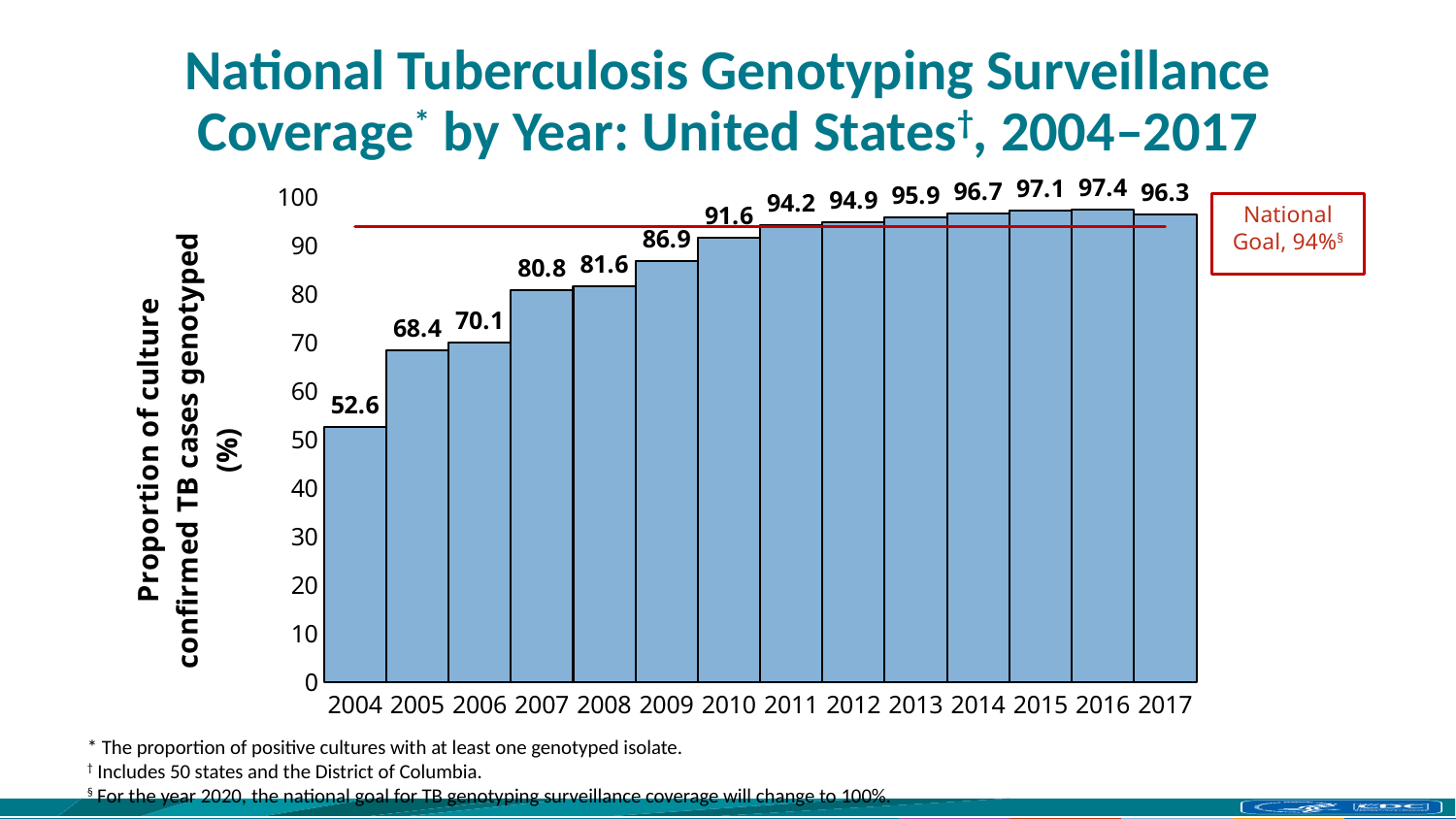
Is the value for 2010 greater or less than 90? greater What is the difference between the values for 2005 and 2004? 15.8 Which year has the lowest value? 2004 Which year has the highest value? 2016 What kind of chart is this? bar chart What is the difference between the values for 2016 and 2017? 1.1 What does the red horizontal line represent? National Goal, 94% How many years are shown on the x axis? 14 What is the value for 2011? 94.2 Which is larger, the value for 2007 or the value for 2009? 2009 What is the value for 2004? 52.6 What is the value for 2017? 96.3